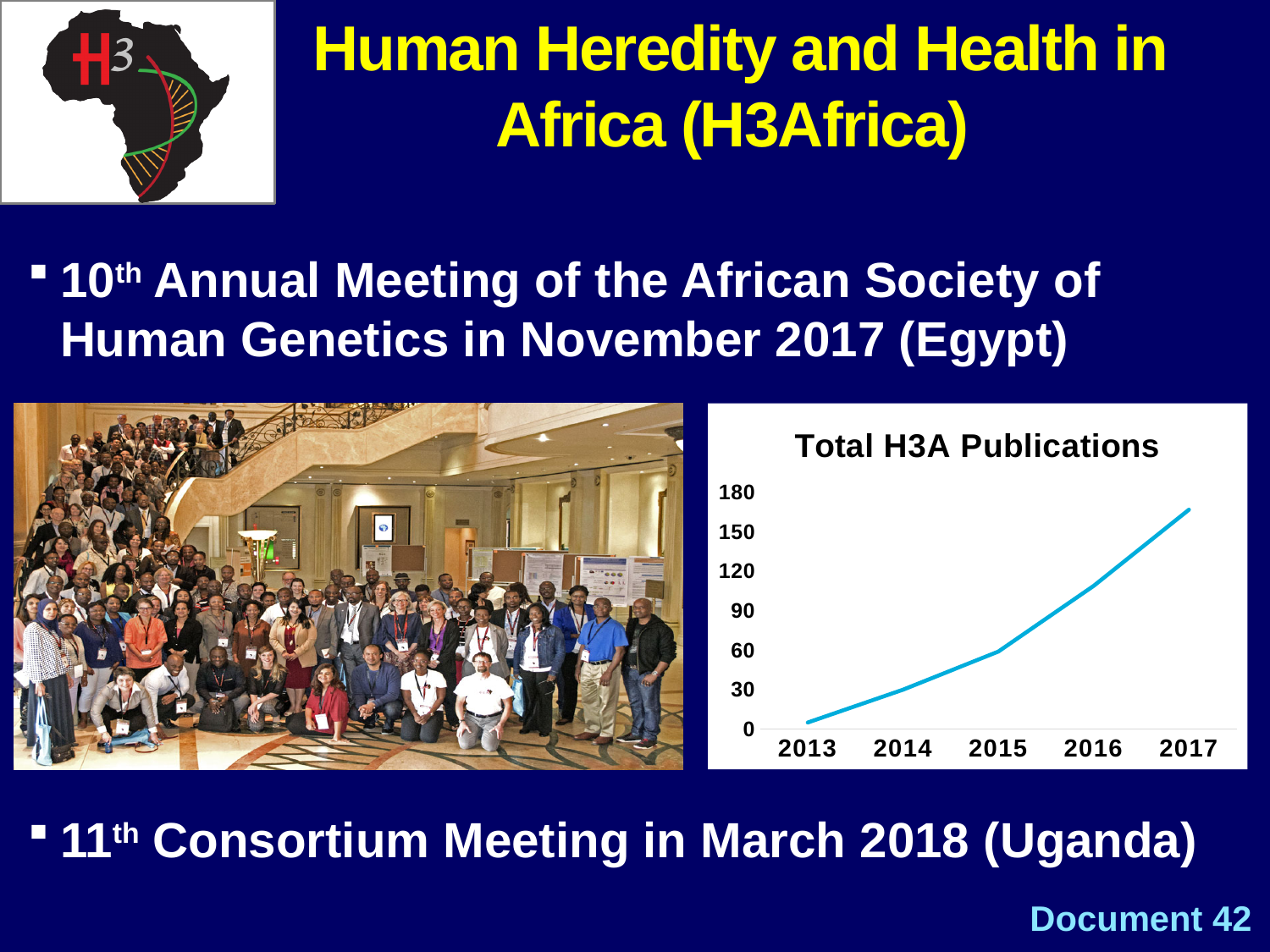
How many years are plotted on the x axis of the Total H3A Publications chart? 5 Do the values in the Total H3A Publications chart rise or fall from 2013 to 2017? rise What is the title of the chart on the slide? Total H3A Publications Which year has the highest value in the Total H3A Publications chart? 2017 Is the value for 2017 in the Total H3A Publications chart greater or less than 150? greater Which year has the lowest value in the Total H3A Publications chart? 2013 Is the value for 2013 in the Total H3A Publications chart greater or less than 30? less In the Total H3A Publications chart, which year has the larger value, 2015 or 2016? 2016 Is the value for 2014 in the Total H3A Publications chart greater or less than 60? less What type of chart is shown on the slide? line chart